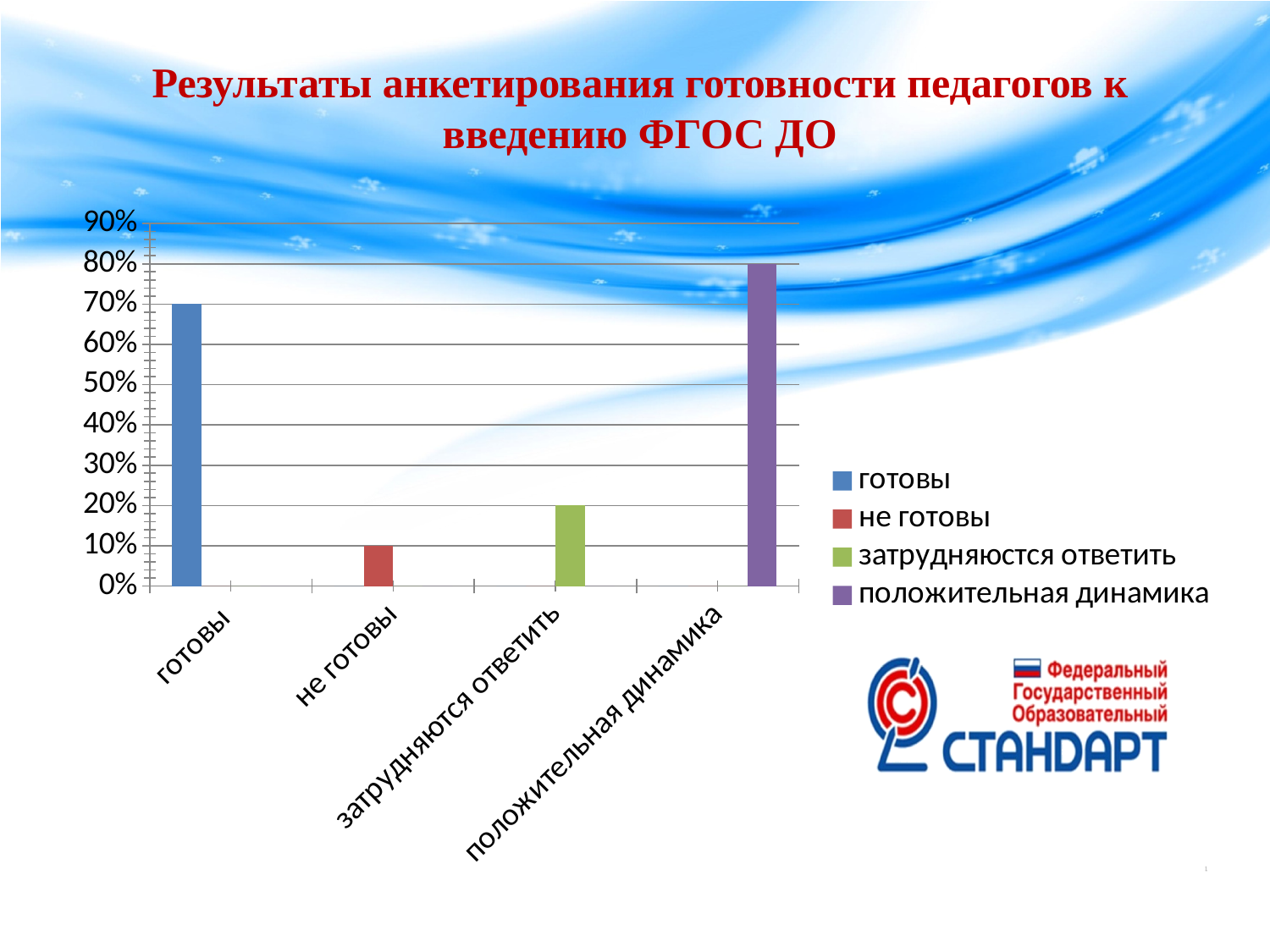
What is the value for готовы? 70% What is the value for положительная динамика? 80% How many entries does the legend list? 4 What kind of chart is shown on the slide? bar chart What is the value for не готовы? 10% Which category has the highest value? положительная динамика Which category has the lowest value? не готовы What is the value for затрудняются ответить? 20% How many categories are shown on the x axis? 4 Which is larger, the value for готовы or the value for затрудняются ответить? готовы What is the difference between the values for положительная динамика and готовы? 10% Is the value for готовы greater or less than 50%? greater